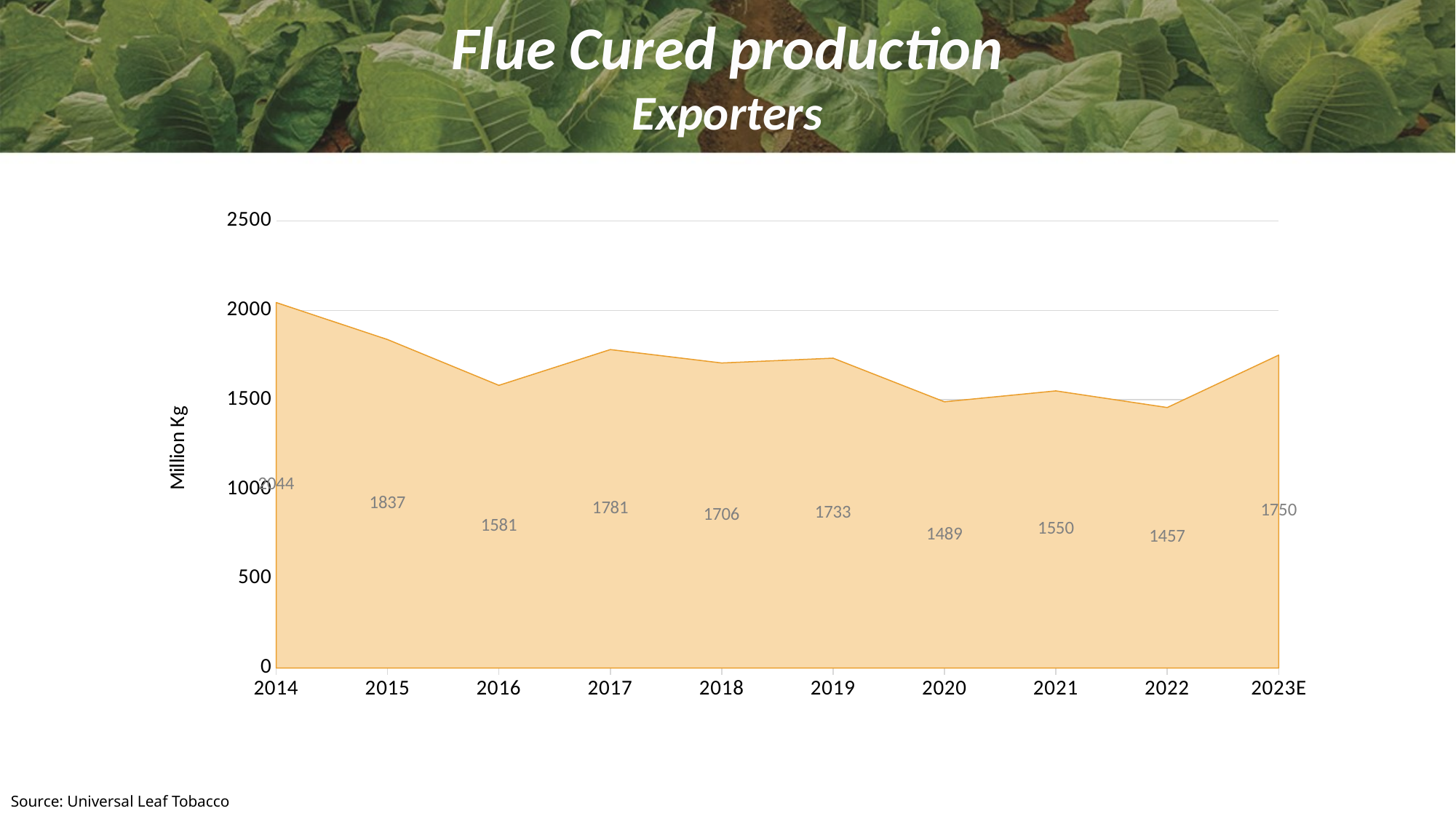
How many years are plotted on the x axis? 10 Which is larger, the value for 2018 or the value for 2019? 2019 Which year has the lowest Flue Cured production? 2022 What is the value shown for 2023E? 1750 What is the Flue Cured production value for 2016? 1581 What is the production value for 2020? 1489 What is the label on the vertical axis? Million Kg Which year has the highest Flue Cured production? 2014 What is the difference between the 2017 value and the 2016 value? 200 Is the value for 2015 greater or less than 1500? greater What kind of chart is shown on the slide? Area chart What is the difference between the 2021 value and the 2022 value? 93